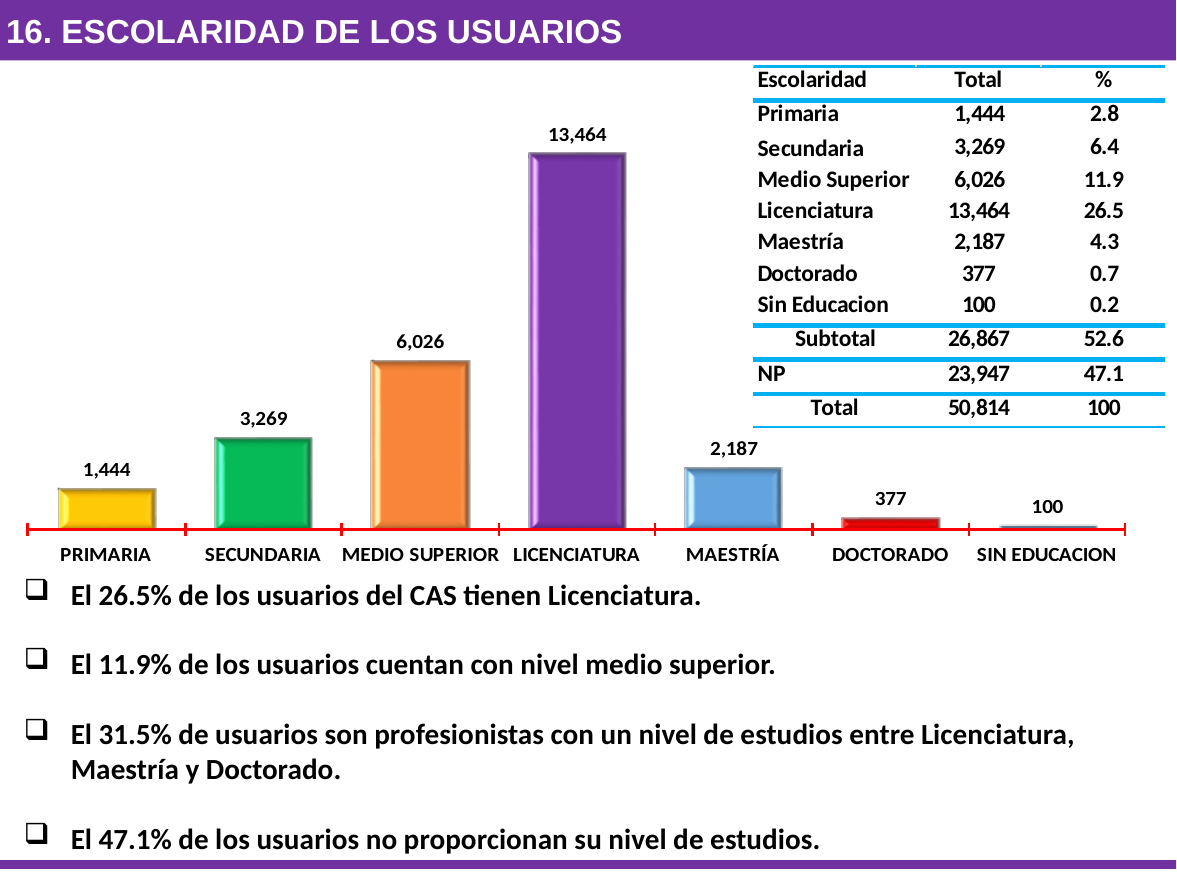
What is the difference between the values for MAESTRÍA and PRIMARIA? 743 What is the value for SECUNDARIA in the bar chart? 3,269 What is the value for DOCTORADO in the bar chart? 377 What colour is the bar for LICENCIATURA? purple What is the difference between the values for LICENCIATURA and MEDIO SUPERIOR? 7,438 Which category has the lowest value in the bar chart? SIN EDUCACION What is the value for LICENCIATURA in the bar chart? 13,464 What kind of chart is shown on the slide? bar chart Which category has the highest value in the bar chart? LICENCIATURA What is the value for MEDIO SUPERIOR in the bar chart? 6,026 How many categories are shown in the bar chart? 7 Which is larger, the value for SECUNDARIA or the value for MAESTRÍA? SECUNDARIA